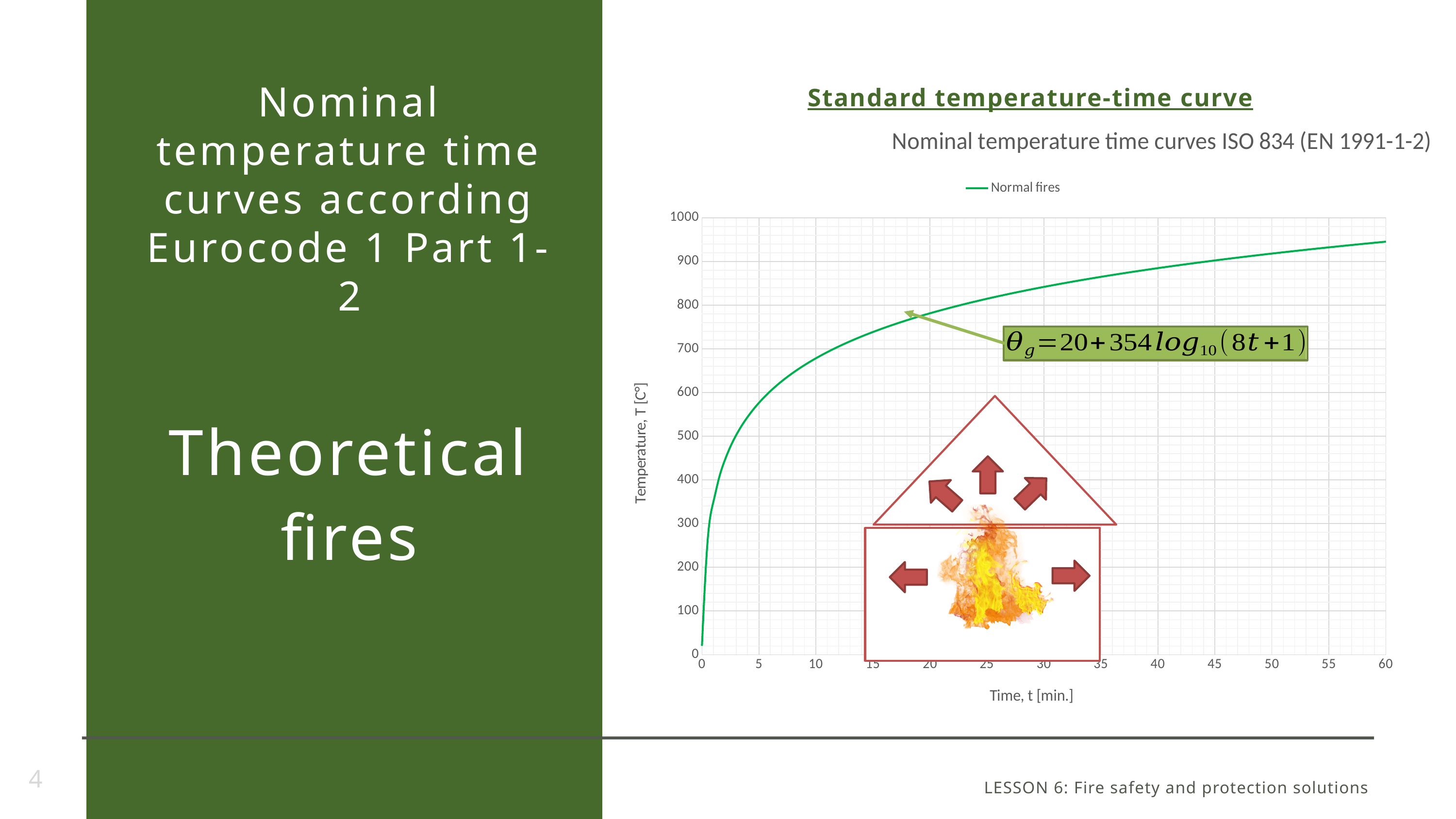
What kind of chart is shown on the slide? line chart Does the temperature rise or fall as time increases along the x axis? rise What is the title of the chart? Nominal temperature time curves ISO 834 (EN 1991-1-2) Is the temperature at 60 minutes greater or less than 900? greater Is the temperature at 50 minutes greater or less than 900? greater Is the temperature at 15 minutes greater or less than 800? less At which time on the x axis does the curve reach its highest temperature? 60 What is the name of the series shown in the chart legend? Normal fires How many series does the chart legend list? 1